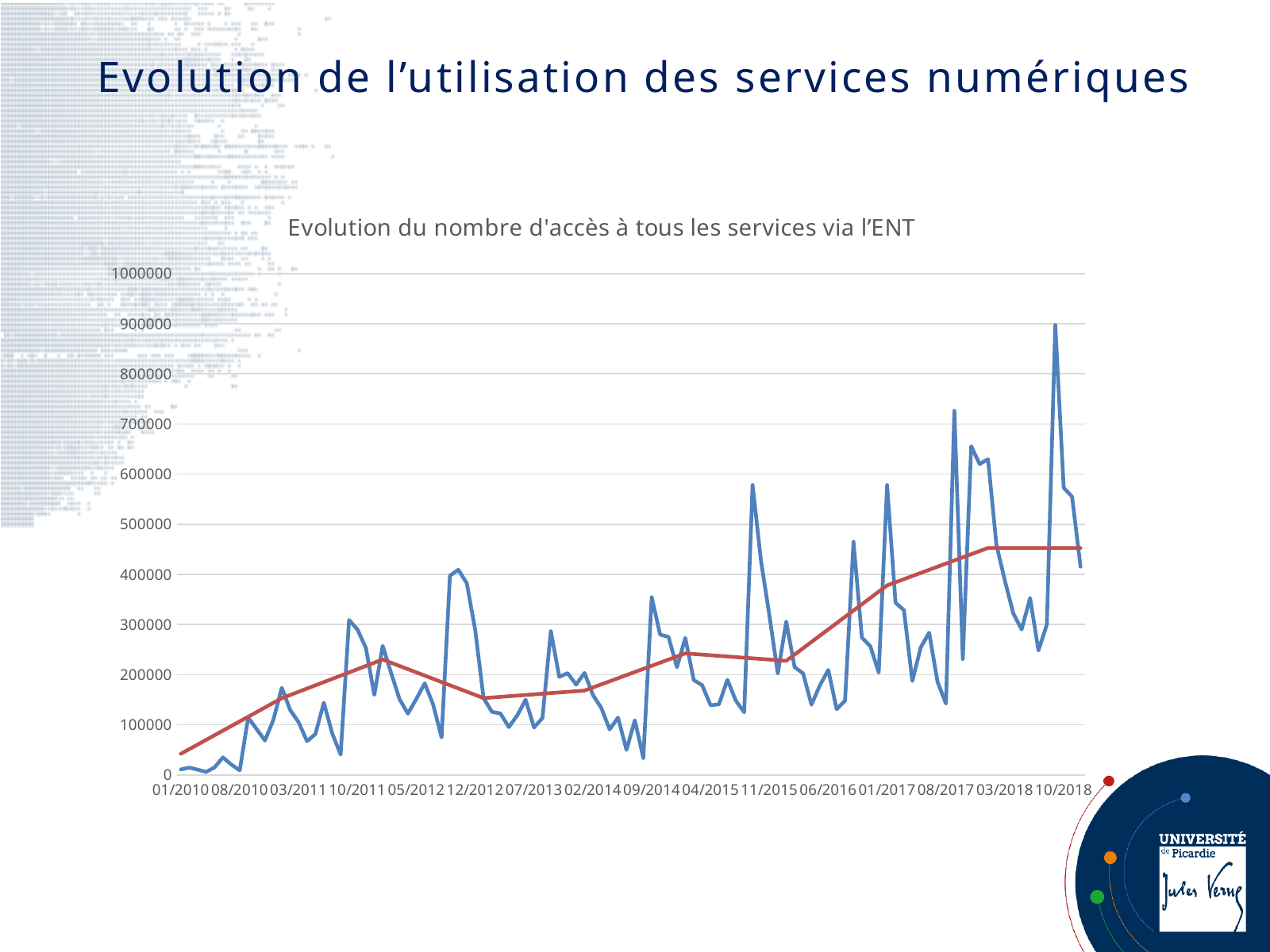
Overall, does the red trend line rise or fall from 01/2010 to 10/2018? rise Is the value of the red line at 01/2010 greater or less than 100000? less Is the value of the red line at 10/2018 greater or less than 400000? greater Is the highest peak of the blue line greater or less than 800000? greater What colours are the two lines on the chart? blue and red How many date labels are shown on the horizontal axis? 16 How many lines are plotted on the chart? 2 What is the highest value shown on the vertical axis? 1000000 What is the title of the chart? Evolution du nombre d'accès à tous les services via l'ENT What kind of chart is shown on the slide? line chart